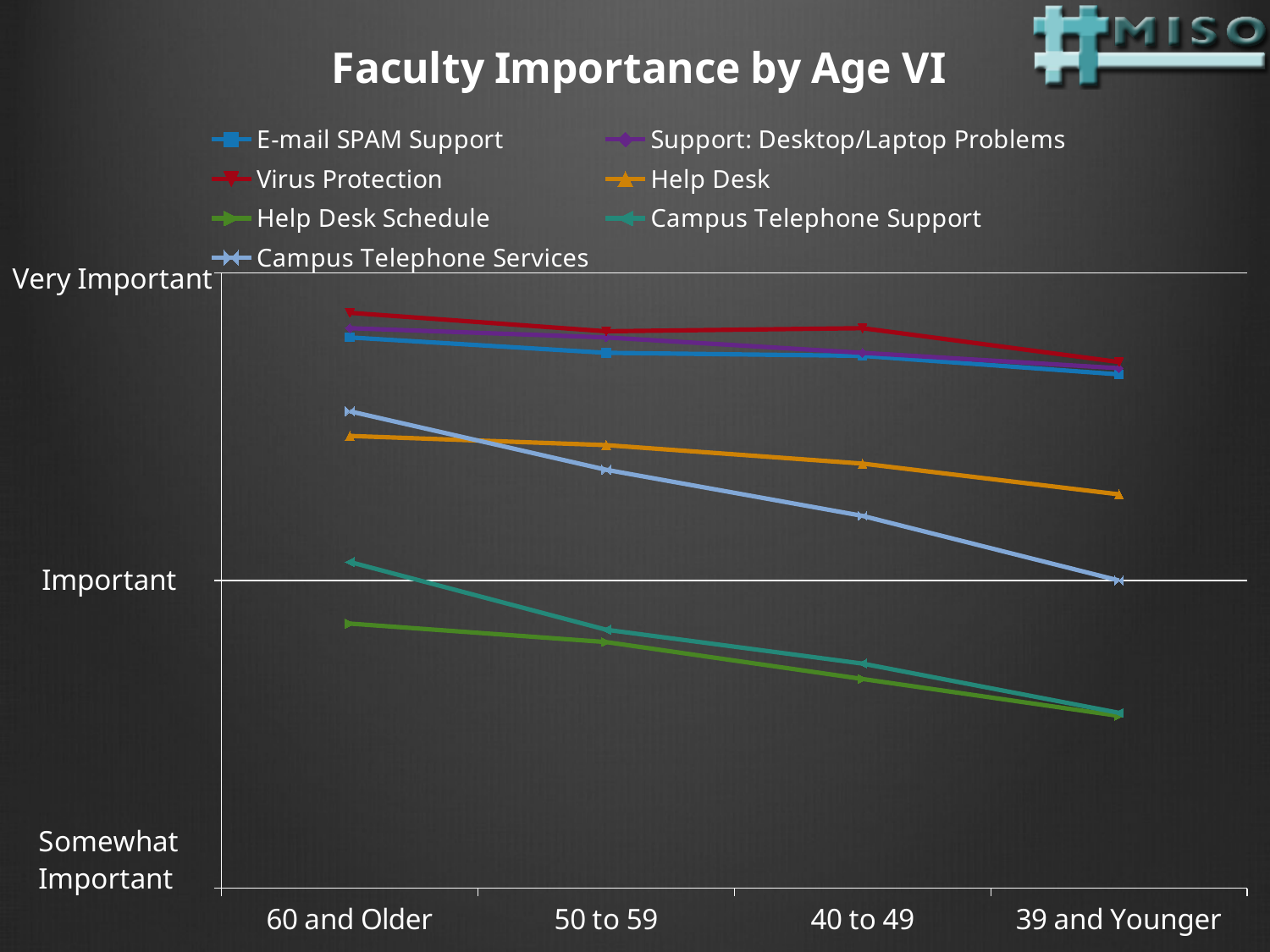
Which series has the highest importance for the 60 and Older group? Virus Protection Is the value for Help Desk at 39 and Younger above or below the 'Important' line? Above What kind of chart is shown on the slide? Line chart For the 60 and Older group, which is rated higher: Campus Telephone Services or Help Desk? Campus Telephone Services Which series has the lowest importance for the 60 and Older group? Help Desk Schedule Is the value for Help Desk Schedule at 60 and Older above or below the 'Important' line? Below How many series does the legend list? 7 Does the importance of Help Desk rise or fall from 60 and Older to 39 and Younger? Fall For the 50 to 59 group, which is rated higher: Help Desk or Campus Telephone Services? Help Desk What is the title of the chart? Faculty Importance by Age VI Does the importance of Campus Telephone Services rise or fall across the age groups from left to right? Fall How many age groups are shown on the x axis? 4